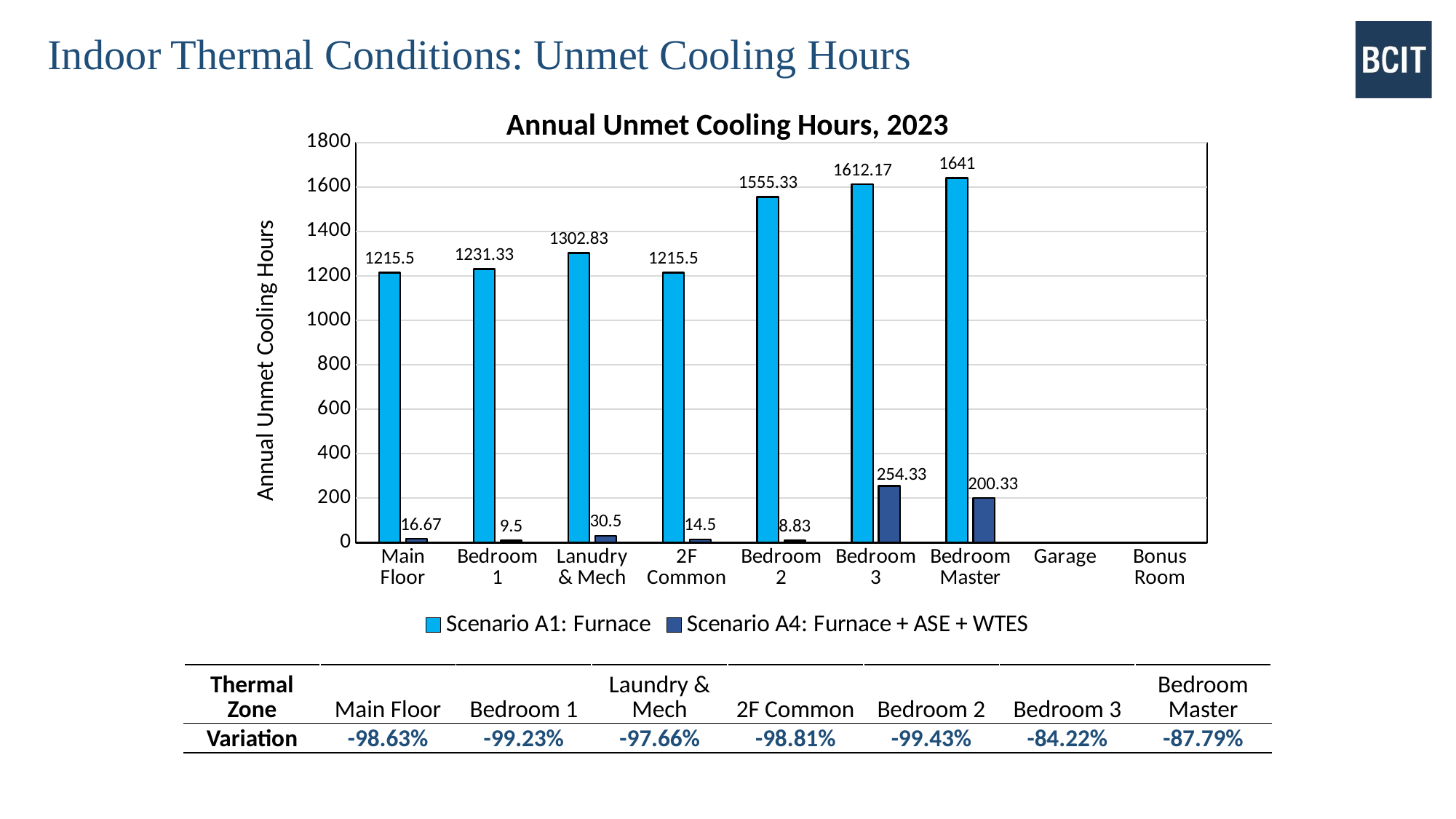
How many series does the legend list? 2 What is the Scenario A4: Furnace + ASE + WTES value for Main Floor? 16.67 What is the Scenario A1: Furnace value for Bedroom 2? 1555.33 What is the difference between the Scenario A1 and Scenario A4 values for Bedroom Master? 1440.67 Which thermal zone has the highest Scenario A1: Furnace value? Bedroom Master What is the Scenario A4: Furnace + ASE + WTES value for Bedroom 3? 254.33 Which has the larger Scenario A1: Furnace value, Laundry & Mech or Bedroom 1? Laundry & Mech What is the difference between the Scenario A4 values for Bedroom 3 and Bedroom Master? 54 Is the Scenario A1: Furnace value for Bedroom 3 greater or less than 1400? greater How many thermal zone categories are shown on the x axis? 9 Which thermal zone has the highest Scenario A4: Furnace + ASE + WTES value? Bedroom 3 What kind of chart is shown on the slide? bar chart